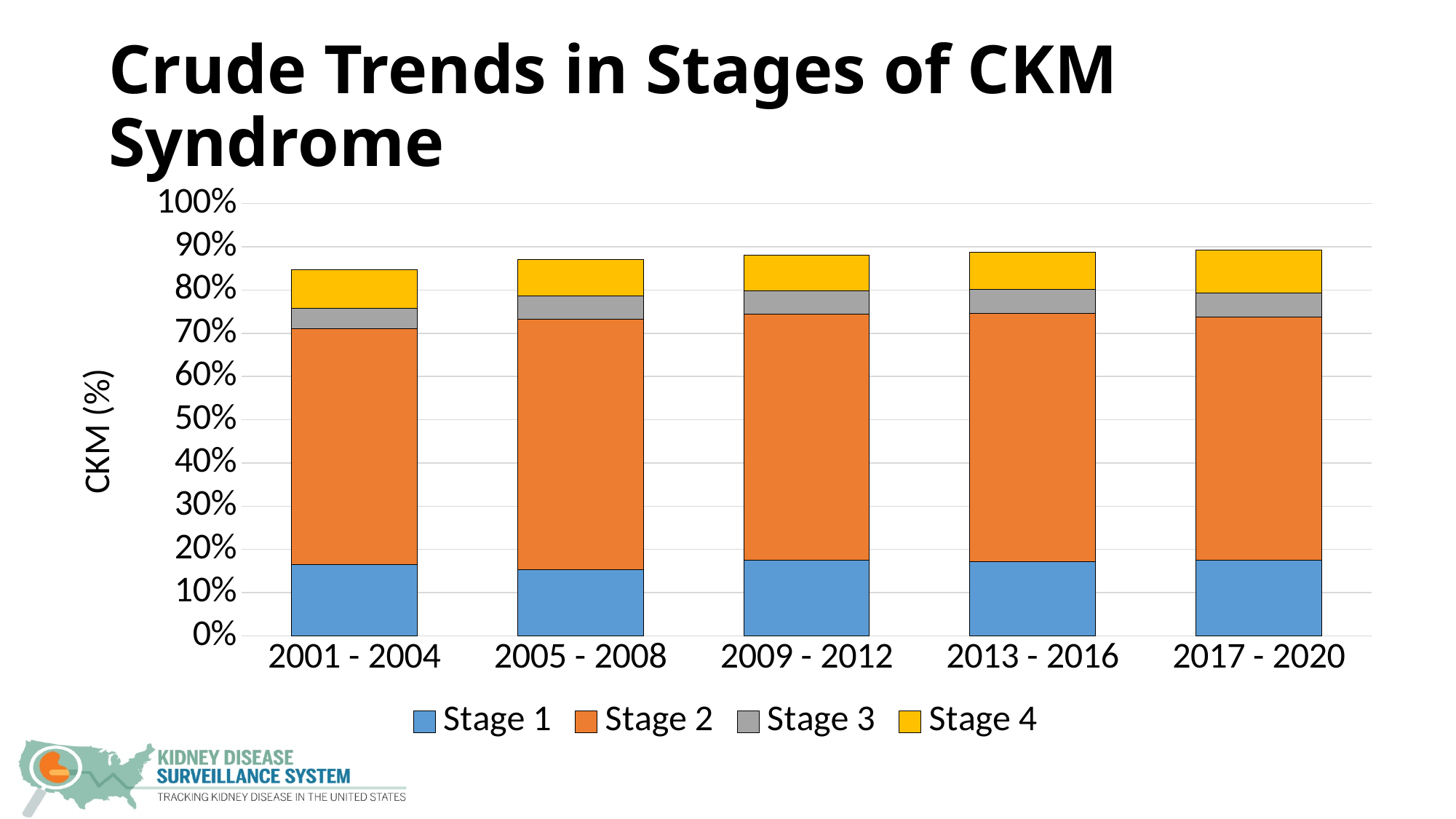
Is the total height of the stacked bar for 2001 - 2004 greater or less than 90%? less How many series does the legend list? 4 What is the label on the y axis? CKM (%) How many time periods are shown on the x axis? 5 Is the Stage 1 value for 2017 - 2020 greater or less than 10%? greater Which time period has the lowest total stacked bar? 2001 - 2004 Is the Stage 1 value for 2001 - 2004 greater or less than 20%? less Do the total heights of the stacked bars rise or fall from 2001 - 2004 to 2017 - 2020? rise What is the title of the chart on the slide? Crude Trends in Stages of CKM Syndrome What kind of chart is shown on the slide? Stacked bar chart In the 2009 - 2012 bar, which segment is larger, Stage 1 or Stage 2? Stage 2